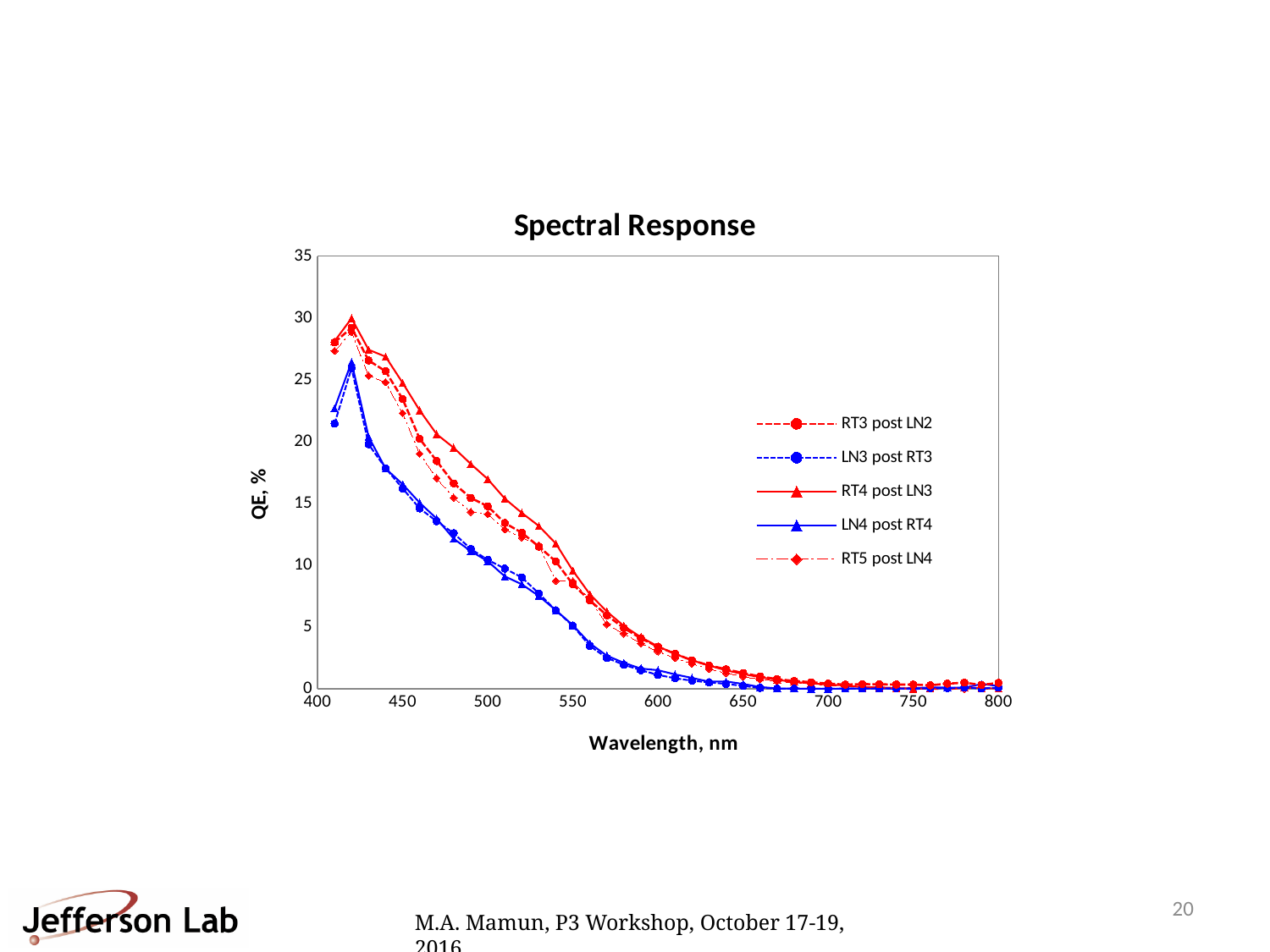
At 500 nm, which series has the larger QE: RT4 post LN3 or LN4 post RT4? RT4 post LN3 Is the value for LN3 post RT3 at 600 nm greater or less than 5? less At 450 nm, which series has the larger QE: LN3 post RT3 or RT4 post LN3? RT4 post LN3 Is the value for RT3 post LN2 at 450 nm greater or less than 20? greater What is the label of the x axis of the chart? Wavelength, nm Beyond the peak near 420 nm, do the QE values rise or fall as wavelength increases? fall What is the title of the chart? Spectral Response Is the value for RT3 post LN2 at 700 nm greater or less than 5? less What kind of chart is shown on the slide? line chart How many series does the legend of the Spectral Response chart list? 5